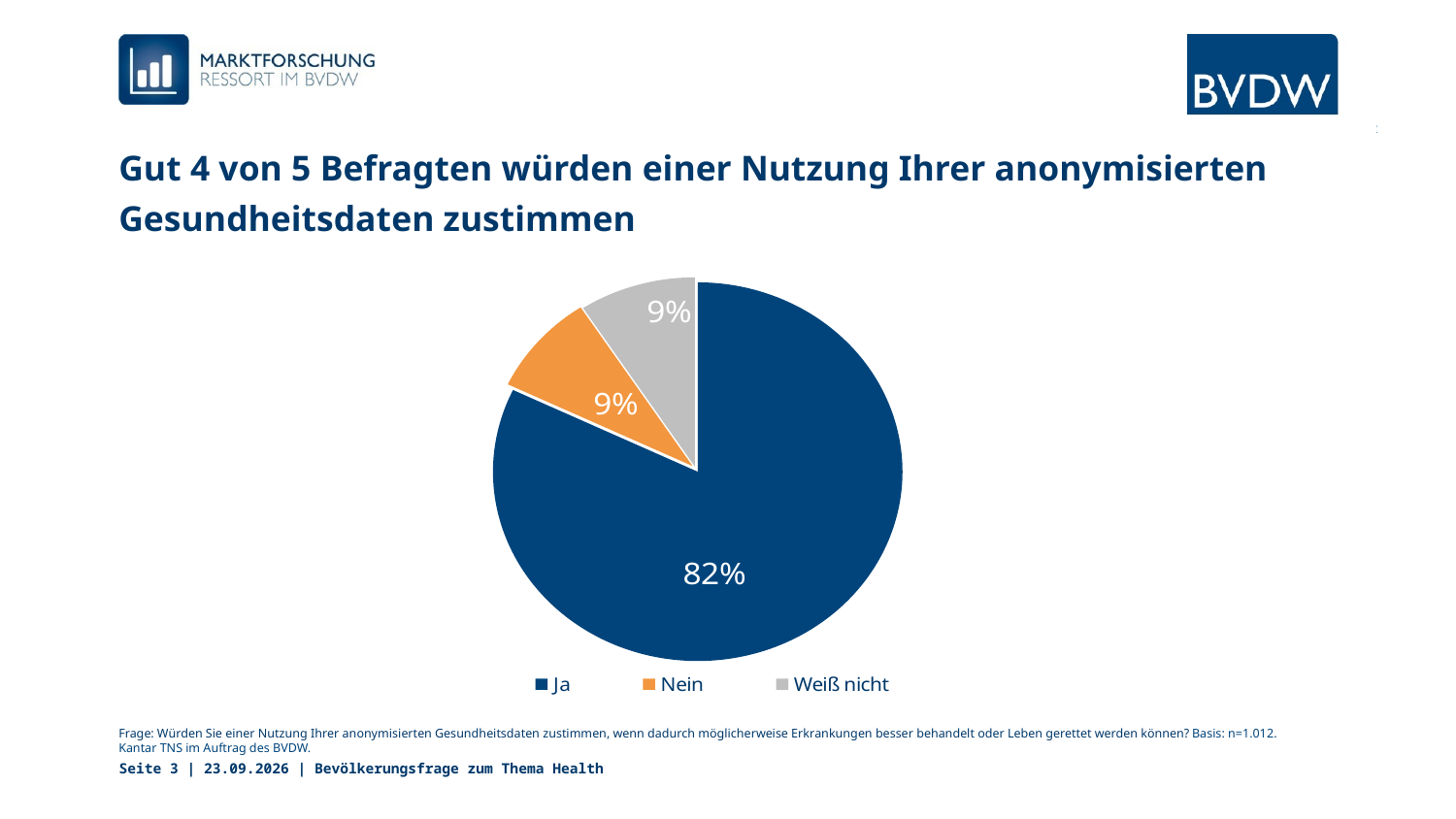
What kind of chart is shown on the slide? Pie chart What percentage of respondents answered "Ja"? 82% How many slices does the pie chart have? 3 Which is larger, the share for "Ja" or the share for "Nein"? Ja What percentage of respondents answered "Weiß nicht"? 9% What is the difference in percentage points between the "Ja" and "Nein" shares? 73 percentage points Which colour represents "Weiß nicht" in the pie chart? Grey Which colour represents "Nein" in the pie chart? Orange How many entries does the legend list? 3 What share of the pie does the "Ja" slice represent? 82% Which answer category has the largest share of the pie? Ja What percentage of respondents answered "Nein"? 9%